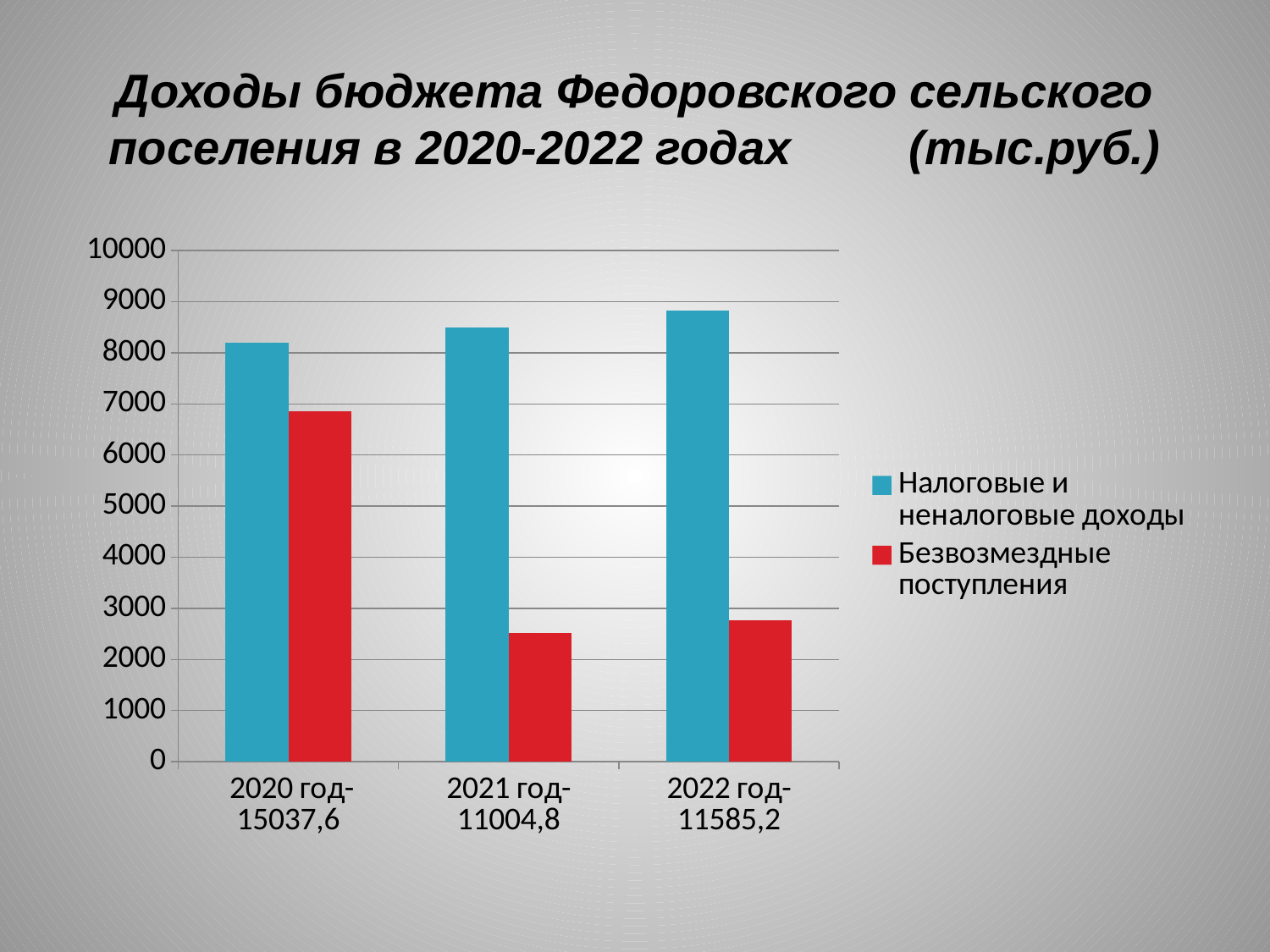
Which series is shown in red in the legend? Безвозмездные поступления How many year categories are shown on the x axis? 3 Is the value of Налоговые и неналоговые доходы for 2020 год greater or less than 8000? greater Is the value of Безвозмездные поступления for 2020 год greater or less than 7000? less Is the value of Безвозмездные поступления for 2021 год greater or less than 3000? less How many series does the legend list? 2 What total is printed in the category label for 2020 год? 15037,6 In which year is Налоговые и неналоговые доходы the highest? 2022 год In which year is Безвозмездные поступления the highest? 2020 год What kind of chart is shown on the slide? bar chart What total is printed in the category label for 2021 год? 11004,8